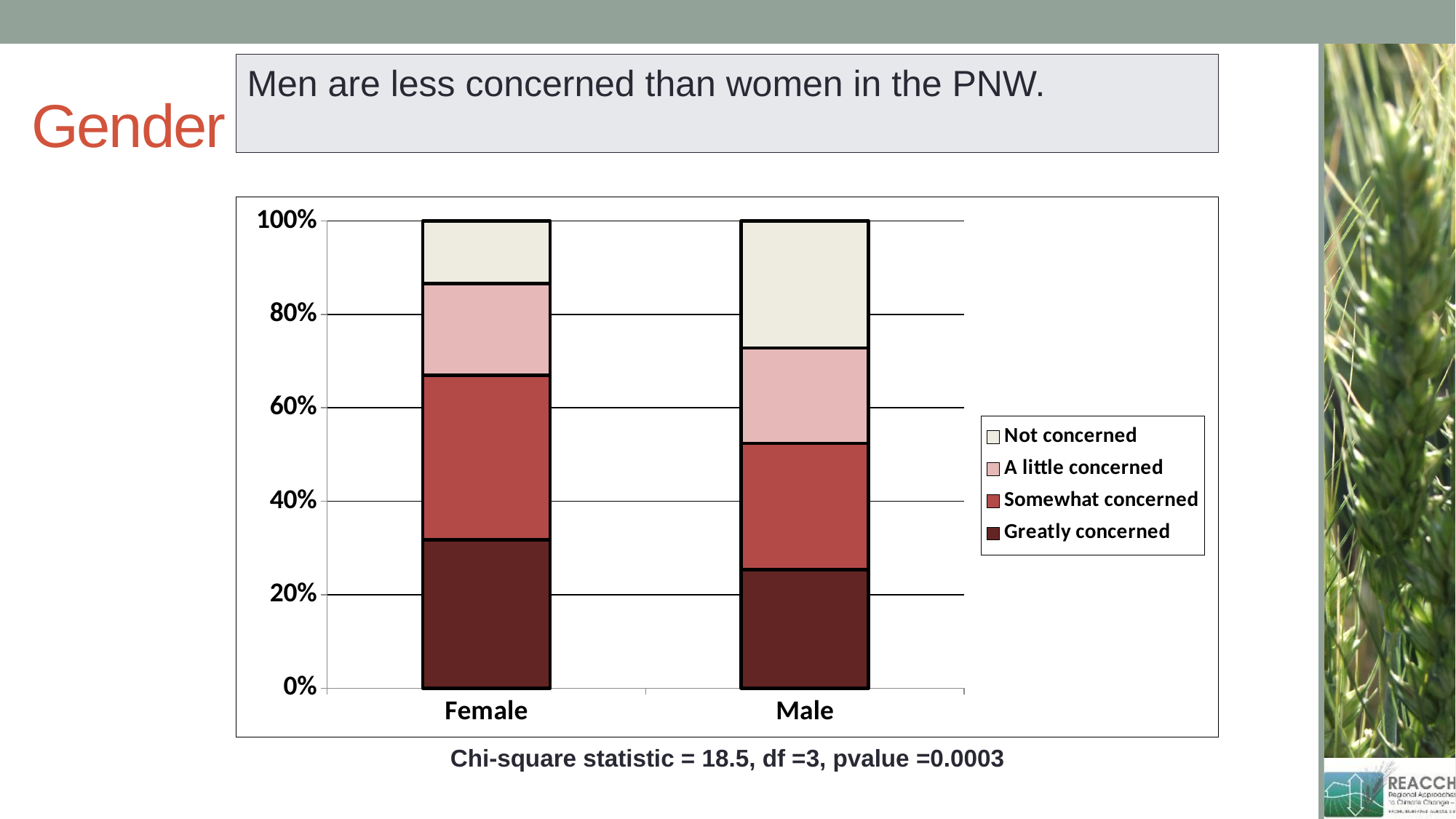
What is the total height of the Female stacked bar? 100% Is the 'Greatly concerned' share for Female greater or less than 40%? less What chi-square statistic is reported below the chart? 18.5 Is the 'Greatly concerned' share for Female greater or less than 20%? greater What kind of chart is shown on the slide? Stacked bar chart How many series does the chart's legend list? 4 How many categories are shown on the x axis of the chart? 2 Which legend entry is shown with the darkest colour? Greatly concerned Which group has the larger 'Not concerned' share, Female or Male? Male Is the 'Not concerned' share for Female greater or less than 20%? less Which group has the larger 'Greatly concerned' share, Female or Male? Female